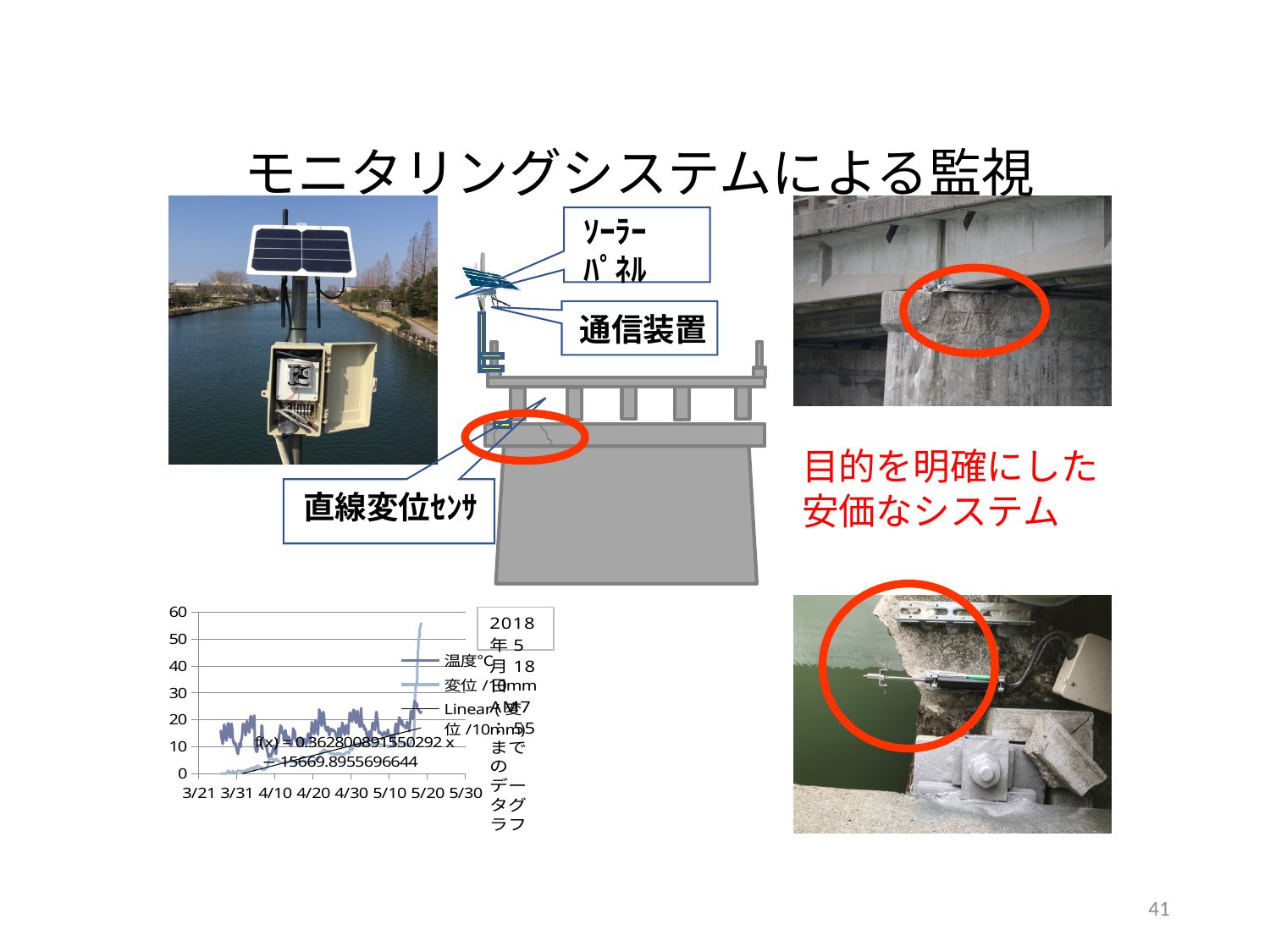
Does the 変位 /10mm series in the bottom-left chart rise or fall from 3/21 to 5/20? rise What is the first date label on the x axis of the bottom-left chart? 3/21 How many date labels are shown on the x axis of the bottom-left chart? 8 Is the peak value of the 変位 /10mm series near 5/20 in the bottom-left chart greater or less than 50? greater What is the last date label on the x axis of the bottom-left chart? 5/30 What is the slope coefficient in the trendline equation f(x) printed on the bottom-left chart? 0.362800891550292 What is the second legend entry of the bottom-left chart? 変位 /10mm What is the highest value shown on the y axis of the bottom-left chart? 60 What is the first legend entry of the bottom-left chart? 温度°C How many entries does the legend of the bottom-left chart list? 3 Is the value of the 変位 /10mm series at 3/21 in the bottom-left chart greater or less than 10? less What kind of chart is shown at the bottom left of the slide? line chart